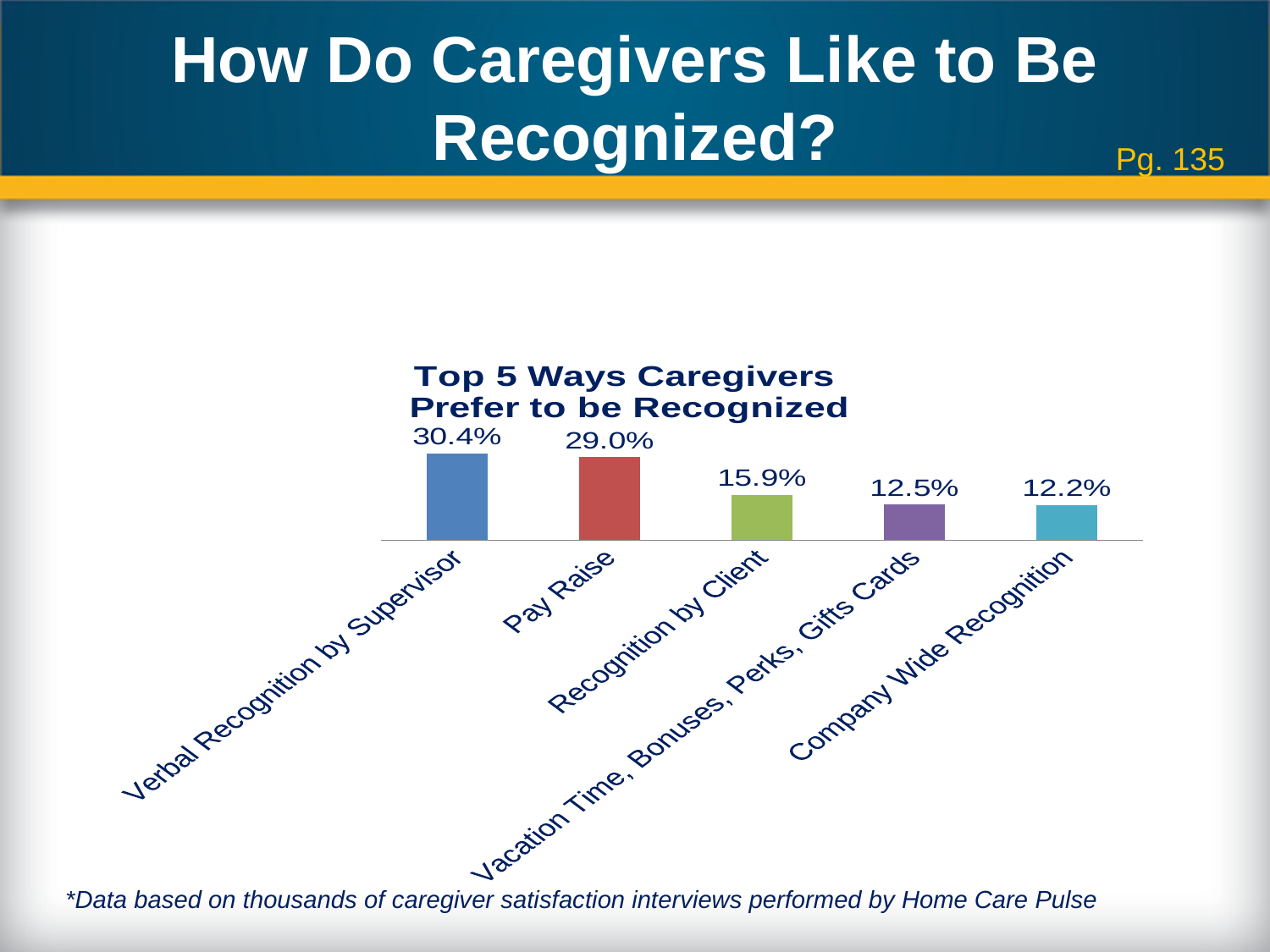
What is the value shown for Pay Raise? 29.0% How many categories are shown in the chart? 5 What is the value for Vacation Time, Bonuses, Perks, Gifts Cards? 12.5% What is the difference between Verbal Recognition by Supervisor and Pay Raise? 1.4% What percentage is shown for Company Wide Recognition? 12.2% Which is larger, Recognition by Client or Company Wide Recognition? Recognition by Client What is the difference between Pay Raise and Recognition by Client? 13.1% What percentage is shown for Recognition by Client? 15.9% Which category has the highest value? Verbal Recognition by Supervisor Which category has the lowest value? Company Wide Recognition What type of chart is shown on the slide? Bar chart What percentage of caregivers prefer Verbal Recognition by Supervisor? 30.4%